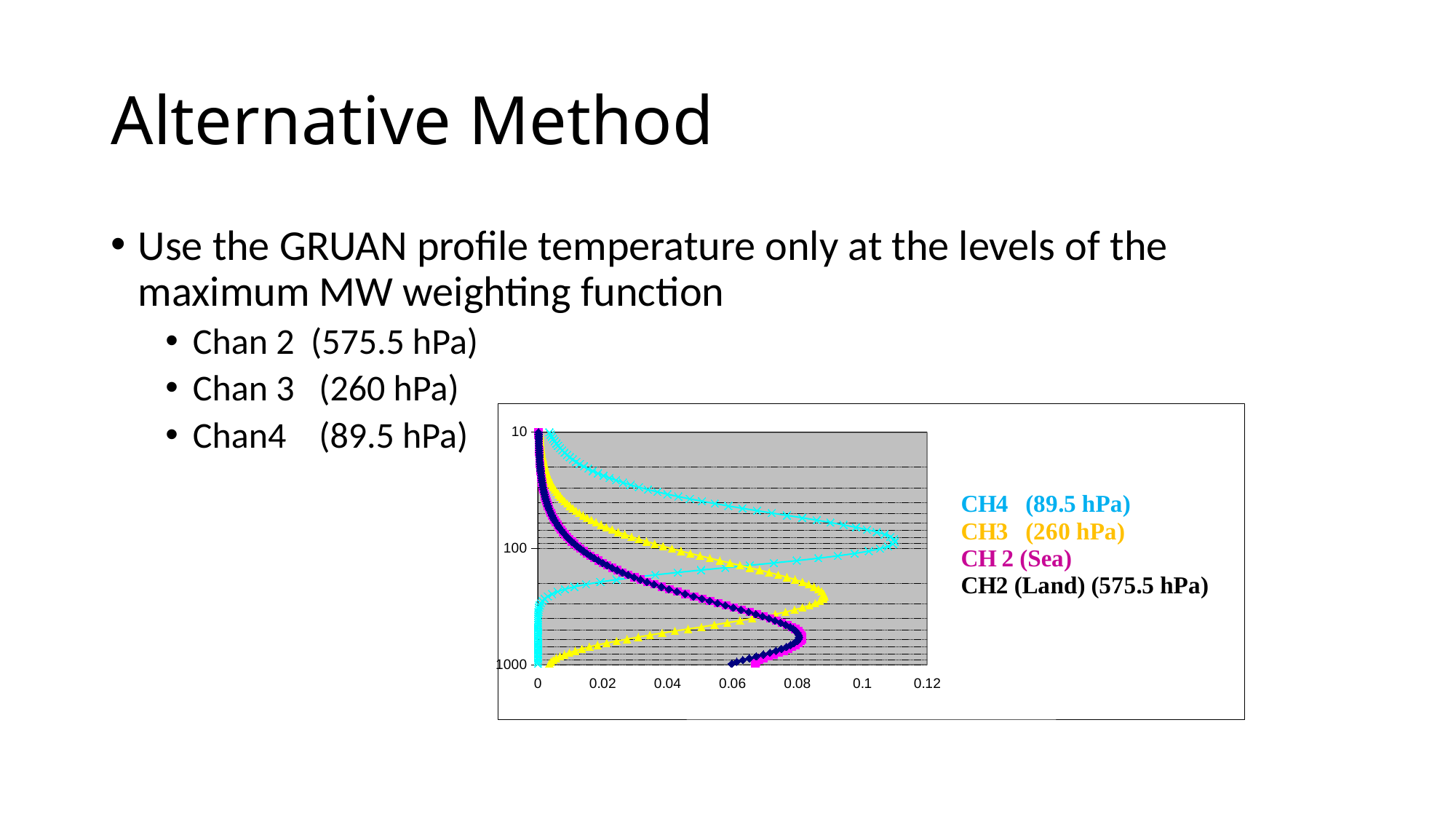
Is the peak value of the CH3 (260 hPa) series greater or less than 0.1? less Which series has a larger peak value, CH3 (260 hPa) or CH2 (Sea)? CH3 (260 hPa) Which series reaches the largest value on the x axis? CH4 (89.5 hPa) Which series has a larger peak value, CH4 (89.5 hPa) or CH3 (260 hPa)? CH4 (89.5 hPa) Is the peak value of the CH3 (260 hPa) series greater or less than 0.08? greater What kind of chart is shown on the slide? line chart How many series does the legend of the chart list? 4 Is the peak value of the CH4 (89.5 hPa) series greater or less than 0.1? greater What colour is the CH3 (260 hPa) series drawn in? yellow What is the largest tick value shown on the x axis of the chart? 0.12